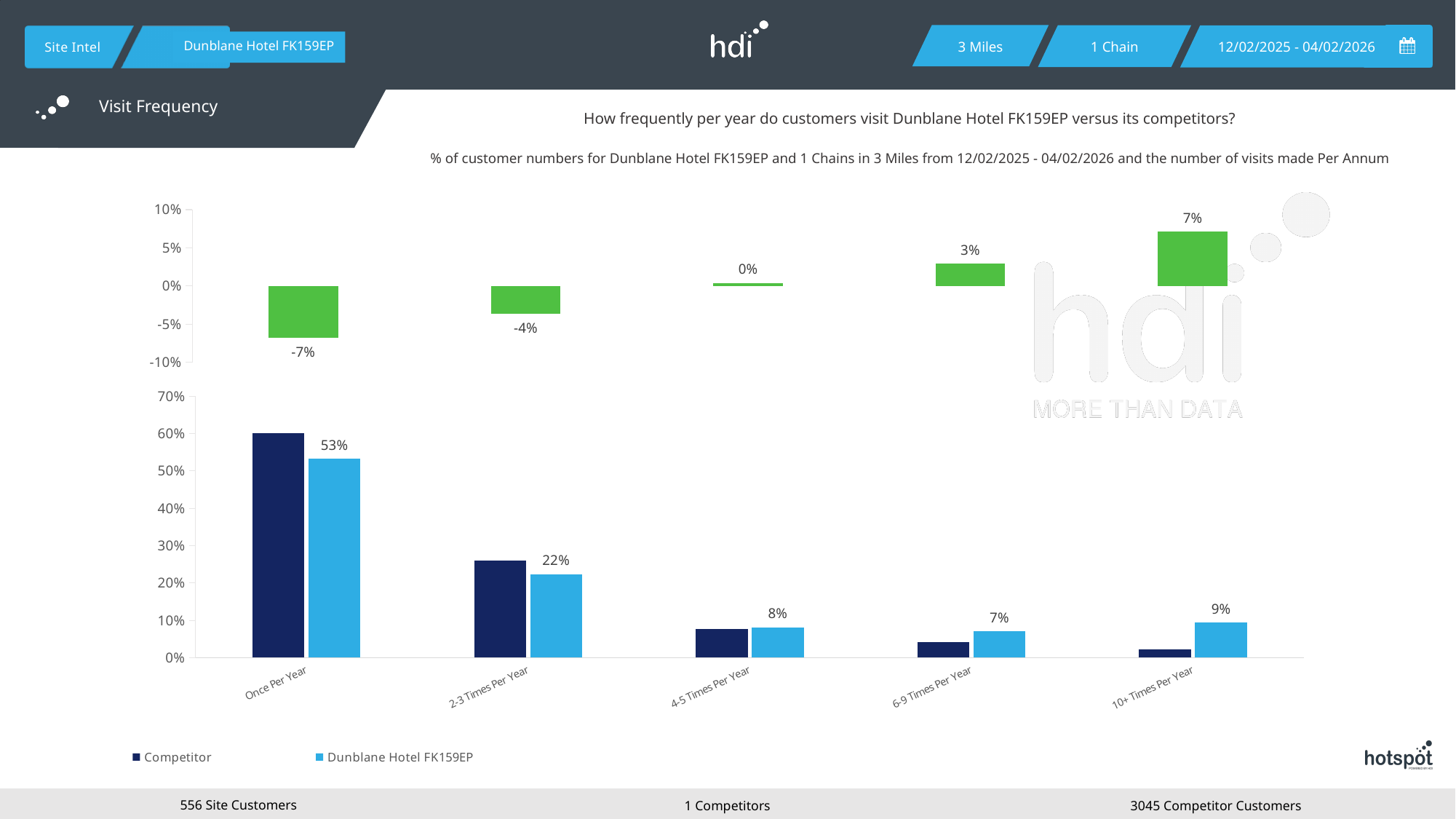
In the top chart, which category has the highest value? 10+ Times Per Year In the bottom chart, is the Competitor value for Once Per Year greater or less than 50%? greater What kind of chart is the bottom chart? Bar chart In the bottom chart, what is the difference between the Dunblane Hotel FK159EP values for Once Per Year and 2-3 Times Per Year? 31% In the bottom chart, what is the value for Dunblane Hotel FK159EP in the 10+ Times Per Year category? 9% In the top chart, what is the value shown for the 6-9 Times Per Year category? 3% In the bottom chart, what is the value for Dunblane Hotel FK159EP in the 2-3 Times Per Year category? 22% In the bottom chart, which is larger for the 10+ Times Per Year category: Competitor or Dunblane Hotel FK159EP? Dunblane Hotel FK159EP In the bottom chart, which category has the lowest value for Dunblane Hotel FK159EP? 6-9 Times Per Year In the top chart, what is the value shown for the Once Per Year category? -7% In the bottom chart, what is the value for Dunblane Hotel FK159EP in the Once Per Year category? 53% How many series does the legend of the bottom chart list? 2